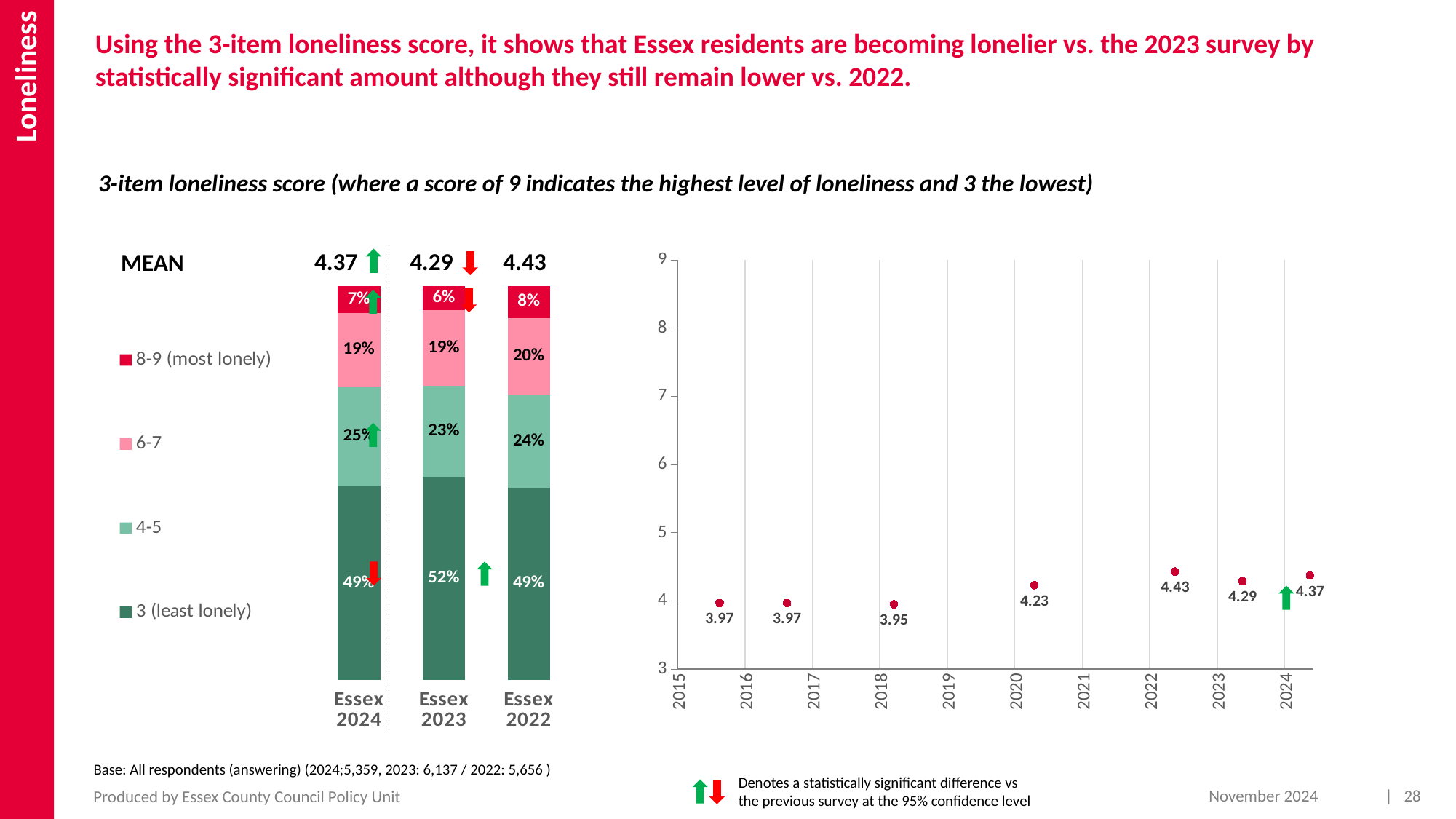
How many series does the legend of the stacked bar chart on the left list? 4 In the stacked bar chart on the left, what is the difference between the 4-5 share for Essex 2024 and Essex 2023? 2% In the chart on the right, is the mean score for 2020 greater or less than 5? less In the stacked bar chart on the left, what percentage of Essex 2023 respondents scored 8-9 (most lonely)? 6% In the stacked bar chart on the left, what percentage of Essex 2022 respondents scored 6-7? 20% In the stacked bar chart on the left, what percentage of Essex 2024 respondents scored 3 (least lonely)? 49% In the stacked bar chart on the left, which survey year has the highest share of respondents scoring 3 (least lonely)? Essex 2023 What is the mean 3-item loneliness score shown for Essex 2024 above the stacked bar chart? 4.37 In the stacked bar chart on the left, is the 8-9 (most lonely) share larger for Essex 2022 or Essex 2024? Essex 2022 In the chart on the right, which year has the highest mean loneliness score? 2022 How many data points are plotted in the chart on the right? 7